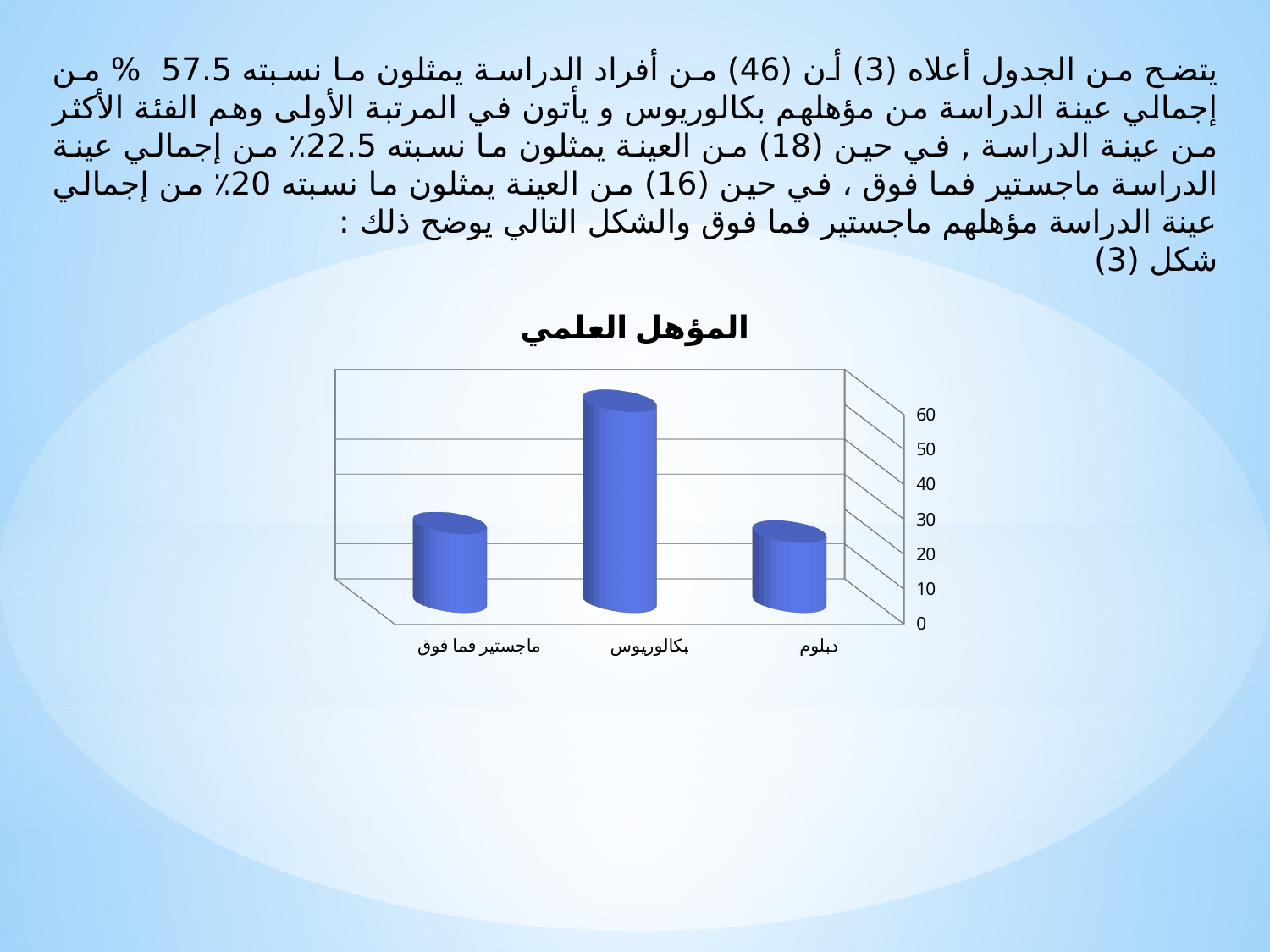
Which is larger, the value for بكالوريوس or the value for دبلوم? بكالوريوس How many categories are shown on the x axis of the chart? 3 What is the title of the chart? المؤهل العلمي Is the value for دبلوم greater or less than 30? less Is the value for بكالوريوس greater or less than 50? greater Is the value for ماجستير فما فوق greater or less than 30? less What kind of chart is shown on the slide? bar chart Which category has the highest bar in the chart? بكالوريوس Which is larger, the value for بكالوريوس or the value for ماجستير فما فوق? بكالوريوس What is the highest tick value shown on the vertical axis of the chart? 60